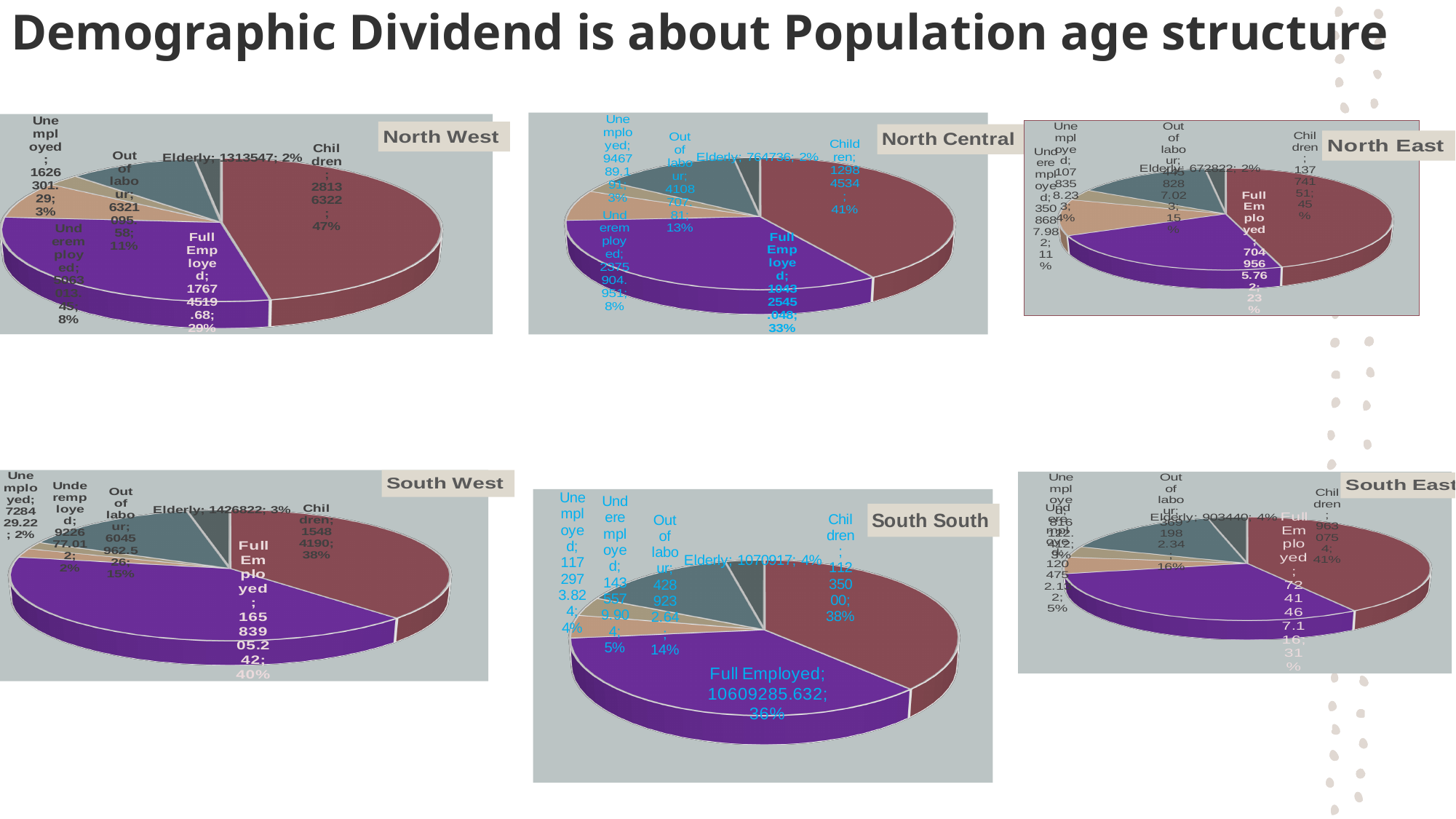
In the South East chart, what share is Full Employed? 31% In the North Central chart, which category has the largest slice? Children What kind of chart is used for the North West region? Pie chart In the North West chart, what is the value shown for Elderly? 1313547 In the South South chart, what is the value shown for Full Employed? 10609285.632 In the South West chart, which is larger, Full Employed or Children? Full Employed In the North West chart, what share of the population is Children? 47% In the South South chart, what share is Elderly? 4% How many pie charts are shown on the slide? 6